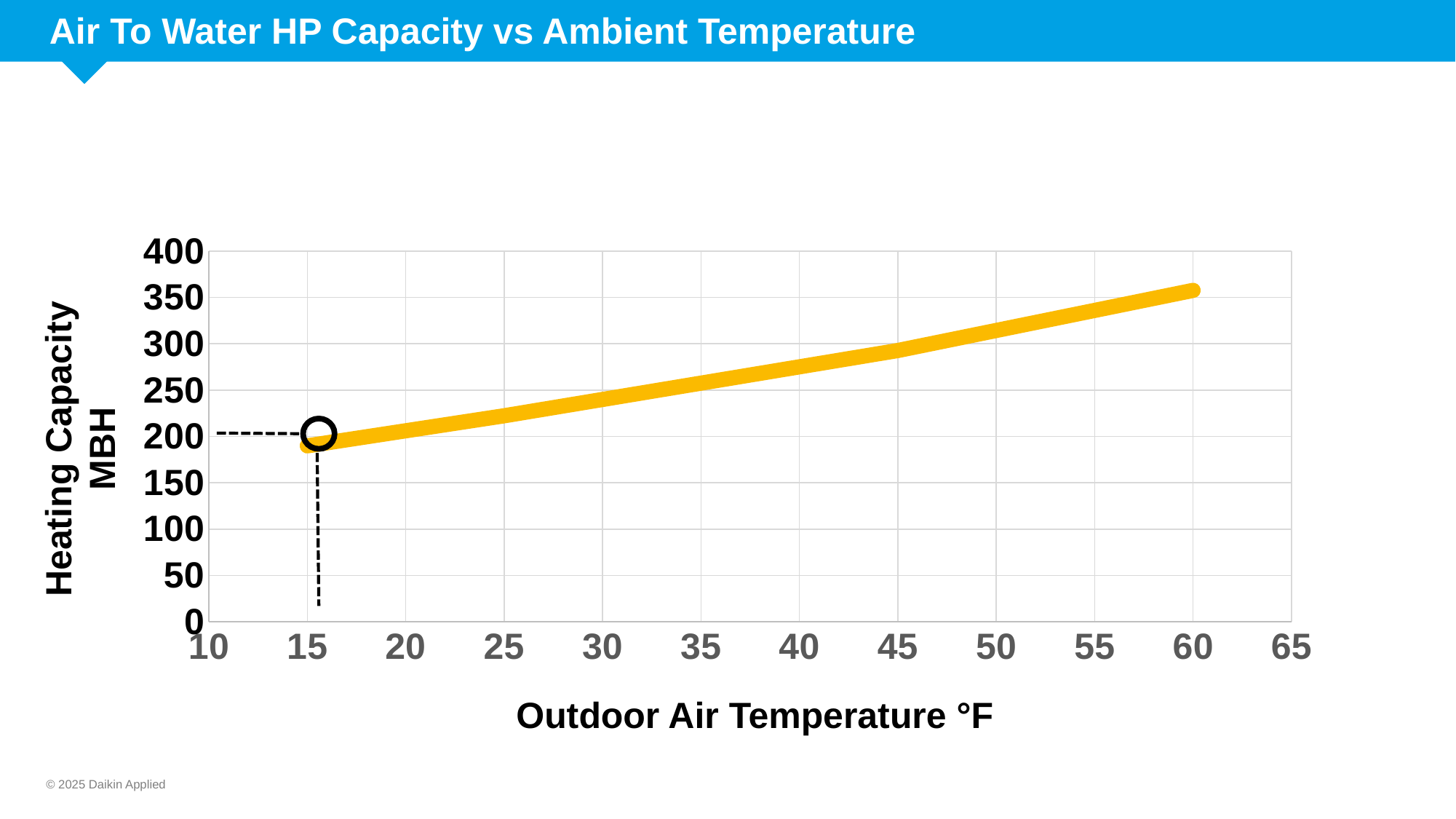
What is the label of the x axis? Outdoor Air Temperature °F Is the heating capacity at 50 °F outdoor air temperature greater or less than 250 MBH? greater What kind of chart is shown on the slide? line chart Is the heating capacity at 40 °F outdoor air temperature greater or less than 250 MBH? greater Does heating capacity rise or fall as outdoor air temperature increases along the x axis? rise Is the heating capacity at 20 °F outdoor air temperature greater or less than 150 MBH? greater At which outdoor air temperature shown on the line is the heating capacity lowest? 15 °F At which outdoor air temperature shown on the line is the heating capacity highest? 60 °F What is the title of the chart? Air To Water HP Capacity vs Ambient Temperature Which has the larger heating capacity: 60 °F or 20 °F outdoor air temperature? 60 °F